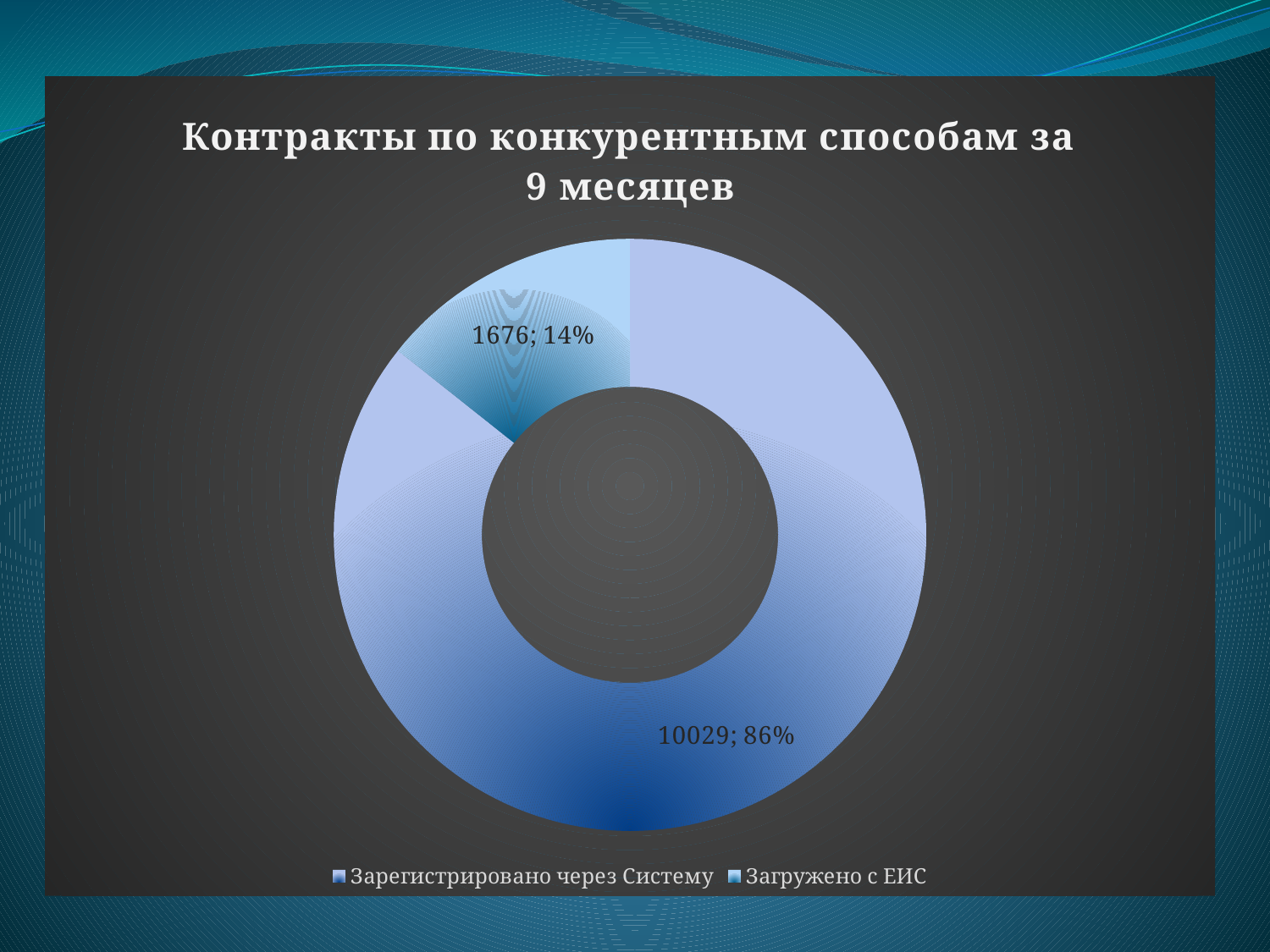
How many categories does the chart show? 2 What is the difference between the values for Зарегистрировано через Систему and Загружено с ЕИС? 8353 What kind of chart is shown on the slide? Doughnut (pie) chart What is the total of the two slices? 11705 Which category has the largest slice? Зарегистрировано через Систему Which category has the smallest slice? Загружено с ЕИС What is the title of the chart? Контракты по конкурентным способам за 9 месяцев What percentage share does Зарегистрировано через Систему have? 86% What is the value for Загружено с ЕИС? 1676 What is the value for Зарегистрировано через Систему? 10029 Which is larger: Зарегистрировано через Систему or Загружено с ЕИС? Зарегистрировано через Систему What percentage share does Загружено с ЕИС have? 14%